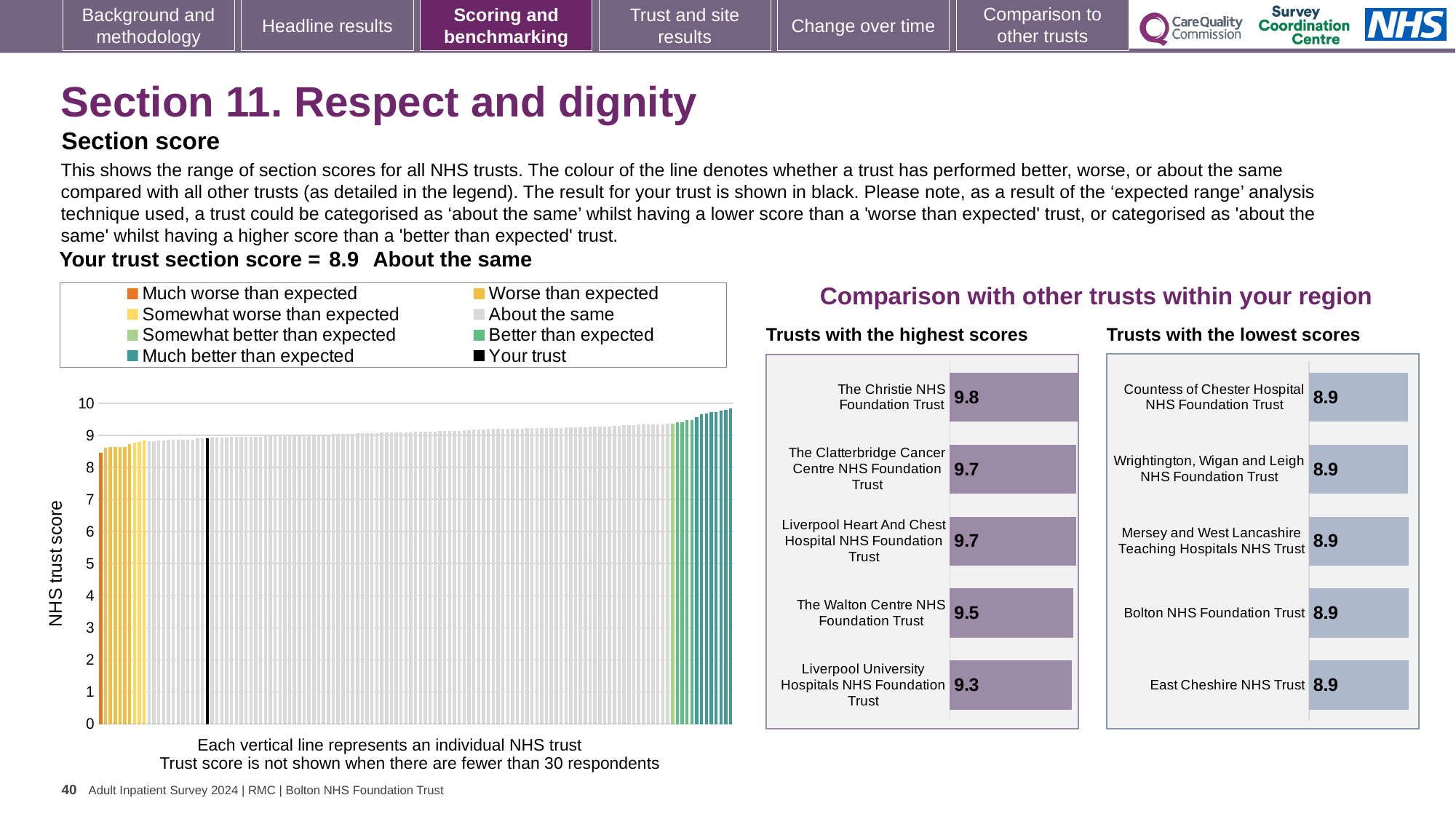
In the 'Trusts with the highest scores' chart, which trust has the highest score? The Christie NHS Foundation Trust In the 'Trusts with the highest scores' chart, what is the score for The Walton Centre NHS Foundation Trust? 9.5 How many entries does the legend of the large chart on the left list? 8 In the 'Trusts with the lowest scores' chart, what is the score for East Cheshire NHS Trust? 8.9 In the 'Trusts with the highest scores' chart, what is the difference between the scores of The Christie NHS Foundation Trust and Liverpool University Hospitals NHS Foundation Trust? 0.5 In the large chart on the left, is the value for the black 'Your trust' bar greater or less than 8? greater In the 'Trusts with the lowest scores' chart, what is the score for Bolton NHS Foundation Trust? 8.9 In the 'Trusts with the highest scores' chart, which trust has the lowest score? Liverpool University Hospitals NHS Foundation Trust In the 'Trusts with the highest scores' chart, what is the score for The Christie NHS Foundation Trust? 9.8 In the 'Trusts with the highest scores' chart, which has the larger score: The Walton Centre NHS Foundation Trust or Liverpool University Hospitals NHS Foundation Trust? The Walton Centre NHS Foundation Trust How many trusts are shown in the 'Trusts with the highest scores' chart? 5 What kind of chart is the large chart on the left showing NHS trust scores? Bar chart